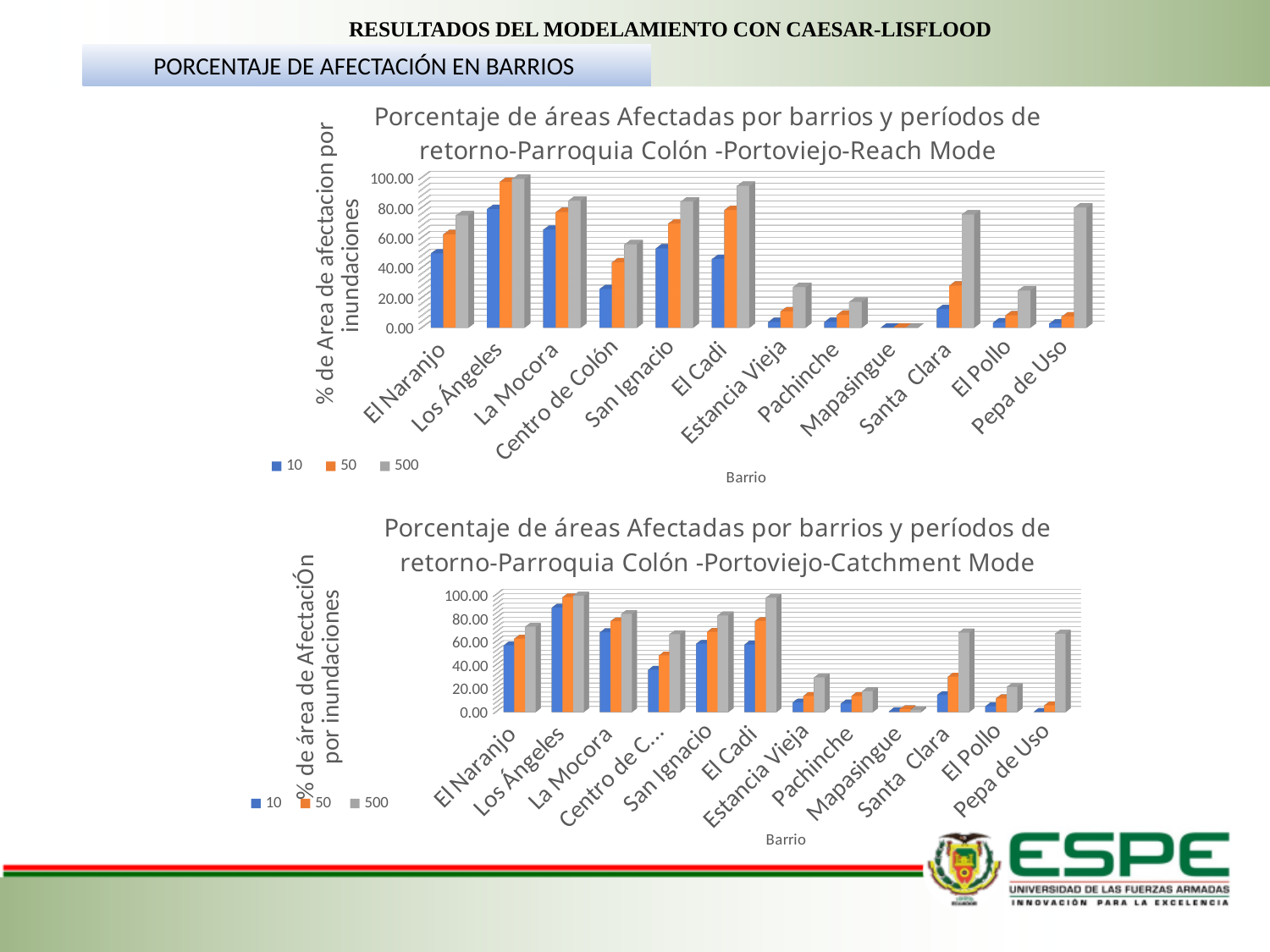
In the top chart (Reach Mode), which barrio has the lowest values across all return periods? Mapasingue In the bottom chart (Catchment Mode), is the value for Pepa de Uso in the 10 series greater or less than 20.00? less In the top chart (Reach Mode), which barrio has the highest value for the 500 series? Los Ángeles In the top chart (Reach Mode), is the value for Centro de Colón in the 10 series greater or less than 40.00? less In the bottom chart (Catchment Mode), is the value for Los Ángeles in the 10 series greater or less than 80.00? greater In the top chart (Reach Mode), which is larger for the 500 series: Los Ángeles or Estancia Vieja? Los Ángeles In the top chart (Reach Mode), how many barrios are shown on the x axis? 12 In the top chart (Reach Mode), how many series does the legend list? 3 In the bottom chart (Catchment Mode), how many series does the legend list? 3 In the top chart (Reach Mode), what kind of chart is shown? bar chart In the bottom chart (Catchment Mode), what is the label of the x axis? Barrio